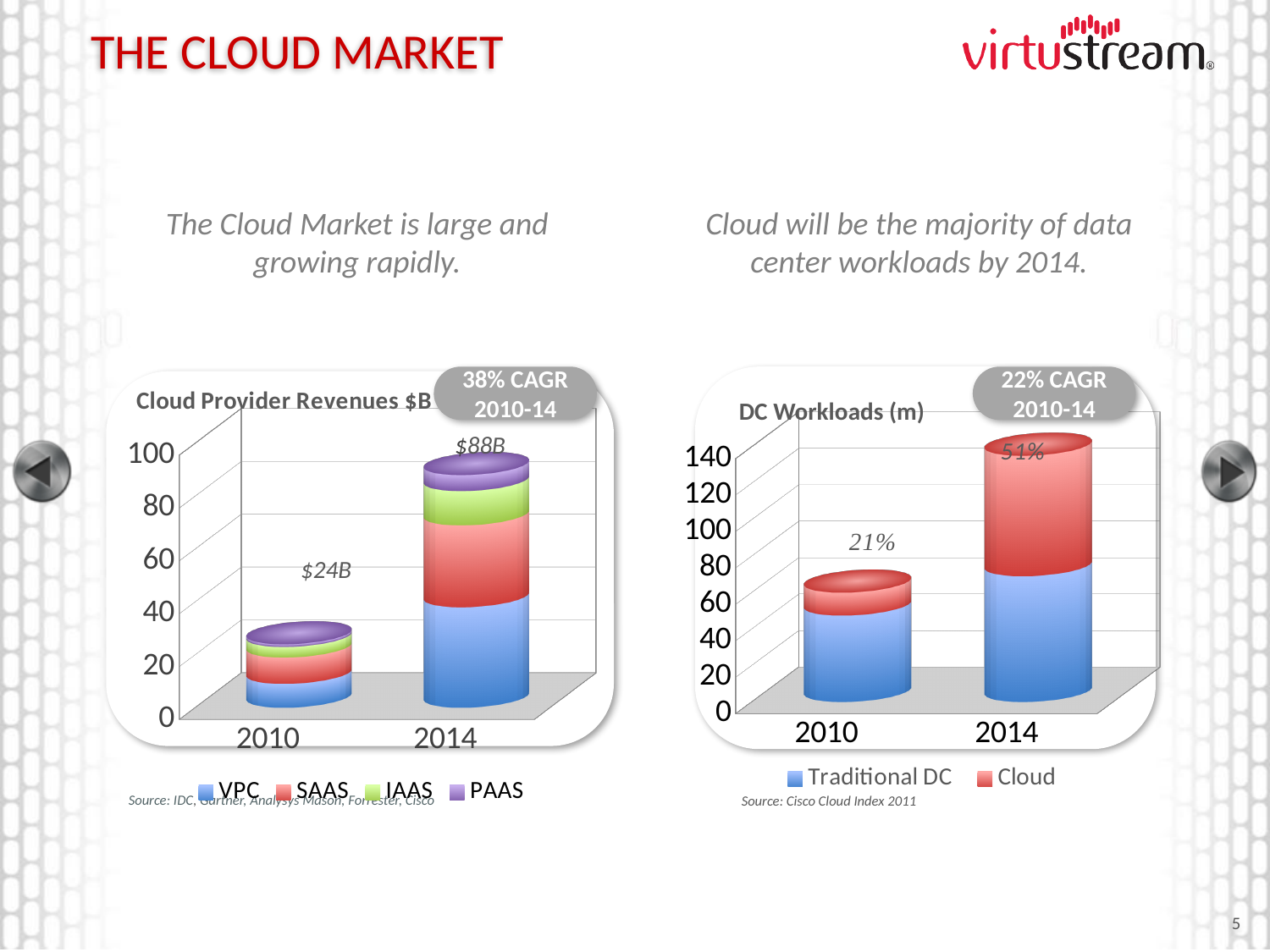
What CAGR for 2010-14 is shown in the callout on the 'DC Workloads (m)' chart? 22% CAGR In the 'DC Workloads (m)' chart, is the total for 2014 greater or less than 120? greater How many series does the legend of the 'DC Workloads (m)' chart on the right list? 2 In the 'DC Workloads (m)' chart, what percentage is labelled on the 2014 bar? 51% In the 'Cloud Provider Revenues $B' chart, what total value is labelled on the 2010 bar? $24B In the 'Cloud Provider Revenues $B' chart, what total value is labelled on the 2014 bar? $88B What kind of chart is the 'Cloud Provider Revenues $B' chart on the left? bar chart How many series does the legend of the 'Cloud Provider Revenues $B' chart list? 4 In the 'Cloud Provider Revenues $B' chart, which year has the taller bar, 2010 or 2014? 2014 In the 'DC Workloads (m)' chart, is the total for 2010 greater or less than 80? less What CAGR for 2010-14 is shown in the callout on the 'Cloud Provider Revenues $B' chart? 38% CAGR In the 'Cloud Provider Revenues $B' chart, what is the difference between the labelled 2014 and 2010 totals? $64B